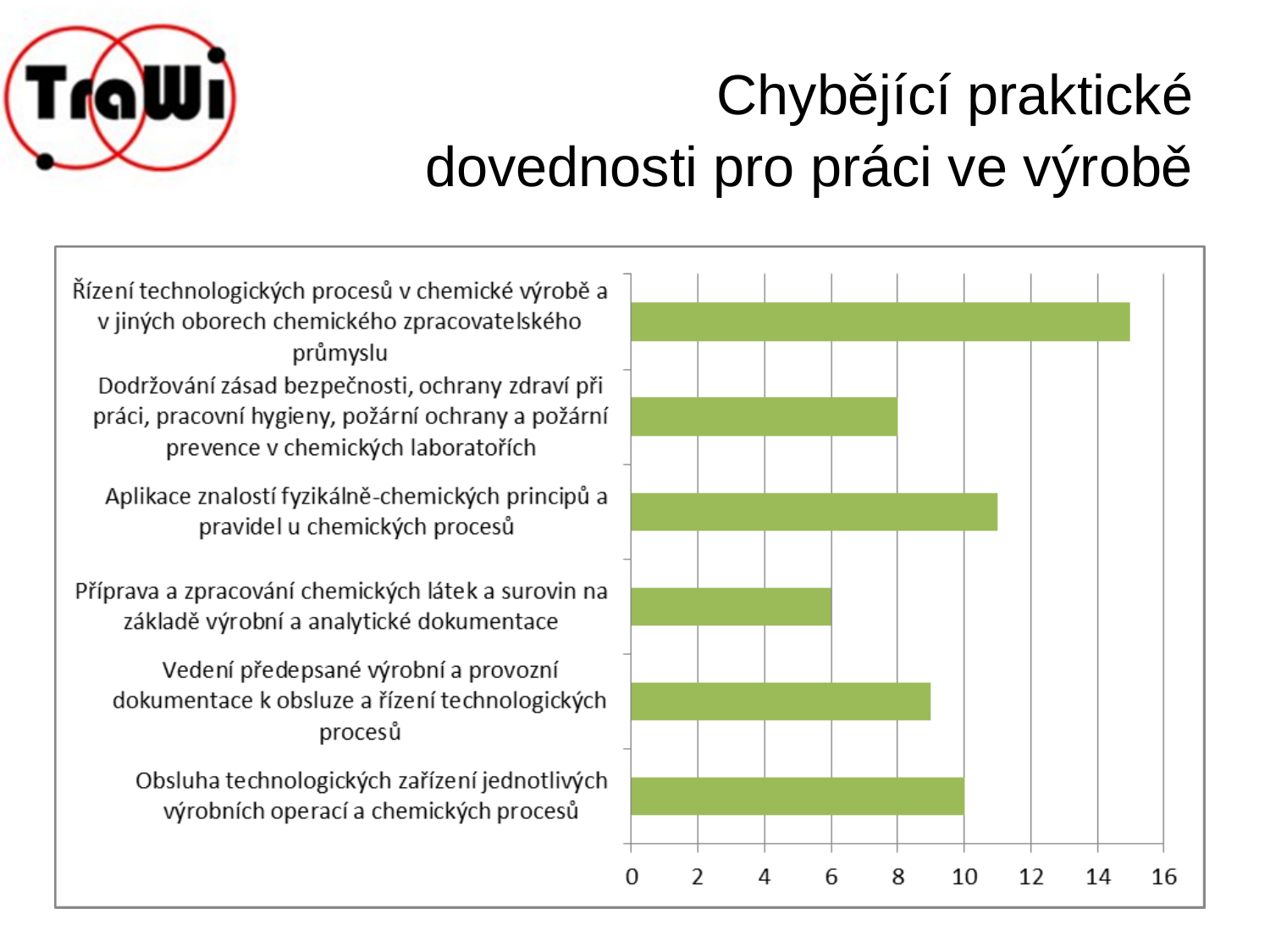
Which category has the lowest value in the chart? Příprava a zpracování chemických látek a surovin na základě výrobní a analytické dokumentace What is the value for 'Obsluha technologických zařízení jednotlivých výrobních operací a chemických procesů'? 10 How many categories (skills) are plotted in the chart? 6 Is the value for 'Řízení technologických procesů v chemické výrobě a v jiných oborech chemického zpracovatelského průmyslu' greater or less than 14? greater Is the value for 'Vedení předepsané výrobní a provozní dokumentace k obsluze a řízení technologických procesů' greater or less than 8? greater What is the value for 'Příprava a zpracování chemických látek a surovin na základě výrobní a analytické dokumentace'? 6 What kind of chart is shown on the slide? bar chart Which category has the highest value in the chart? Řízení technologických procesů v chemické výrobě a v jiných oborech chemického zpracovatelského průmyslu Is the value for 'Aplikace znalostí fyzikálně-chemických principů a pravidel u chemických procesů' greater or less than 12? less What is the difference between the values for 'Obsluha technologických zařízení jednotlivých výrobních operací a chemických procesů' and 'Příprava a zpracování chemických látek a surovin na základě výrobní a analytické dokumentace'? 4 Which is larger: the value for 'Aplikace znalostí fyzikálně-chemických principů a pravidel u chemických procesů' or the value for 'Obsluha technologických zařízení jednotlivých výrobních operací a chemických procesů'? Aplikace znalostí fyzikálně-chemických principů a pravidel u chemických procesů What is the value for 'Dodržování zásad bezpečnosti, ochrany zdraví při práci, pracovní hygieny, požární ochrany a požární prevence v chemických laboratořích'? 8